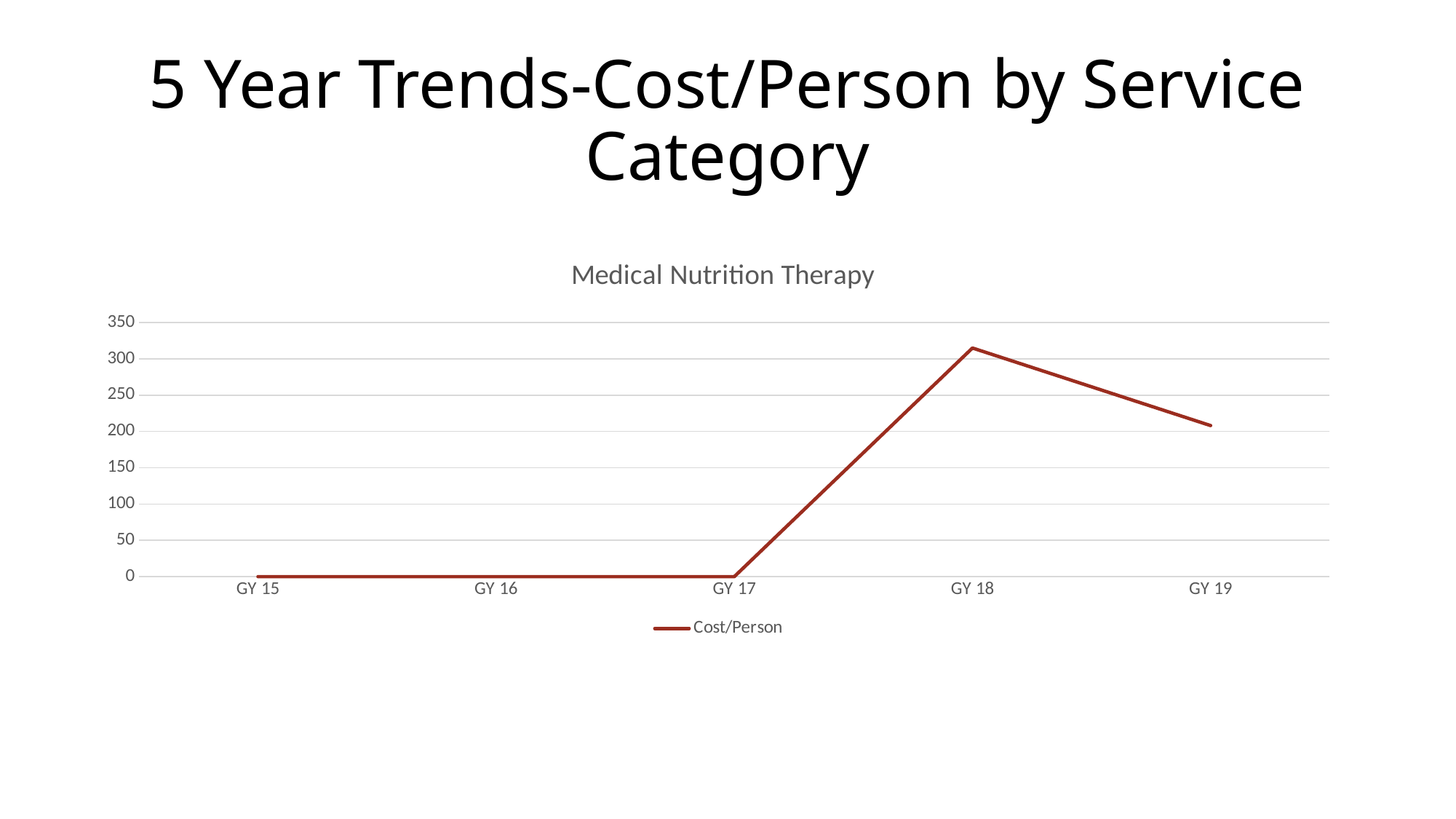
Does the Cost/Person rise or fall from GY 18 to GY 19? fall What is the Cost/Person value for GY 16? 0 Is the Cost/Person for GY 19 greater or less than 250? less What is the title of the chart? Medical Nutrition Therapy Which year has the highest Cost/Person? GY 18 Is the Cost/Person for GY 18 greater or less than 300? greater How many series does the legend list? 1 Which is larger, the Cost/Person for GY 18 or for GY 19? GY 18 How many years are plotted on the x axis? 5 What type of chart is shown on the slide? line chart What is the Cost/Person value for GY 15? 0 What is the name of the series shown in the legend? Cost/Person